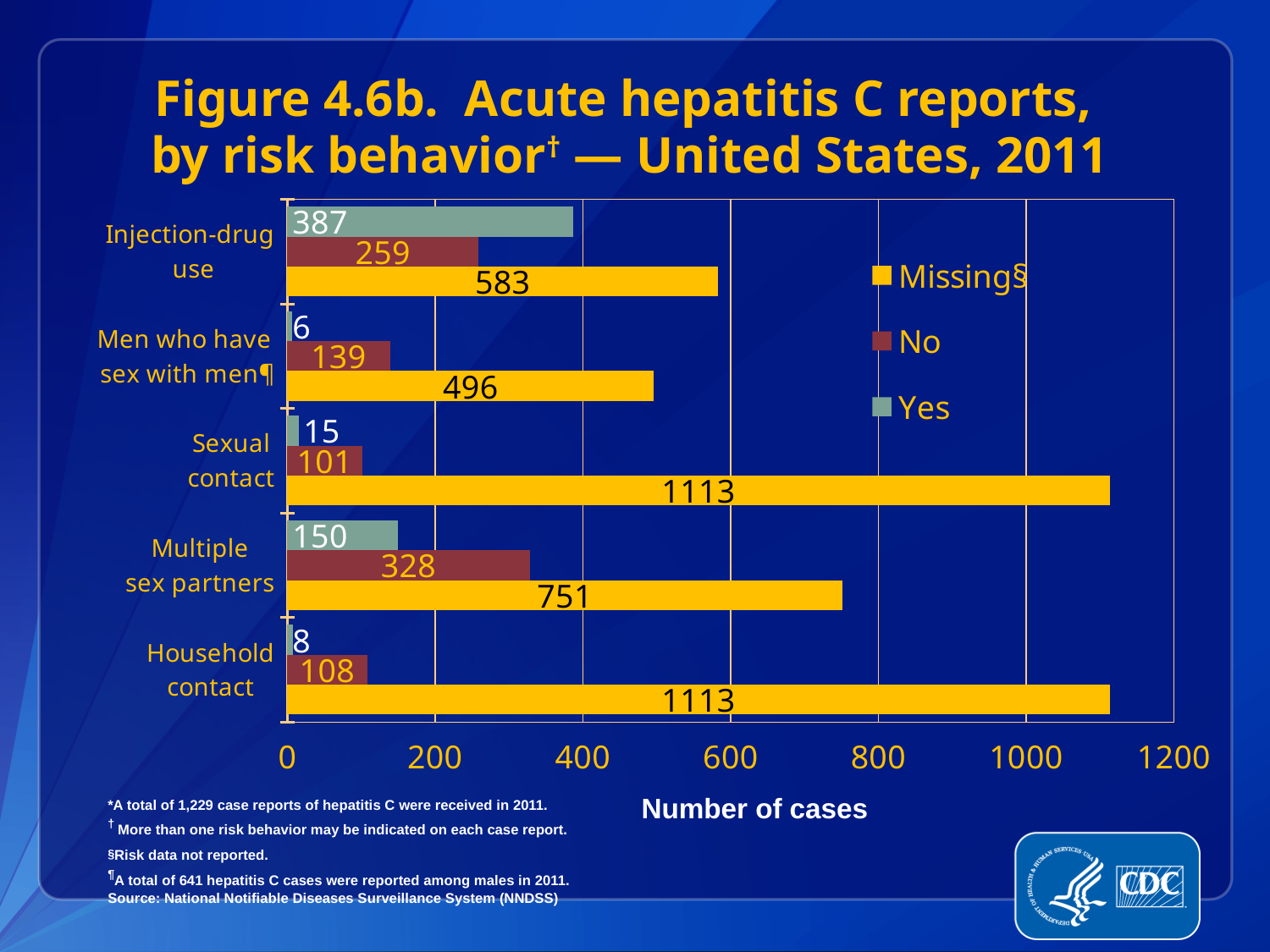
What kind of chart is shown on the slide? Bar chart What is the difference between the 'No' values for Multiple sex partners and Injection-drug use? 69 What is the label of the x axis? Number of cases Which risk behavior has the lowest 'Yes' value? Men who have sex with men How many risk behavior categories are shown on the chart? 5 What is the number of cases with 'No' for Multiple sex partners? 328 What is the number of cases with 'Yes' for Injection-drug use? 387 How many series does the legend list? 3 Which is larger: the 'Missing' value for Multiple sex partners or for Injection-drug use? Multiple sex partners Which risk behavior has the highest 'Yes' value? Injection-drug use What is the number of cases with 'Yes' for Household contact? 8 What is the number of cases with 'Missing' for Sexual contact? 1113